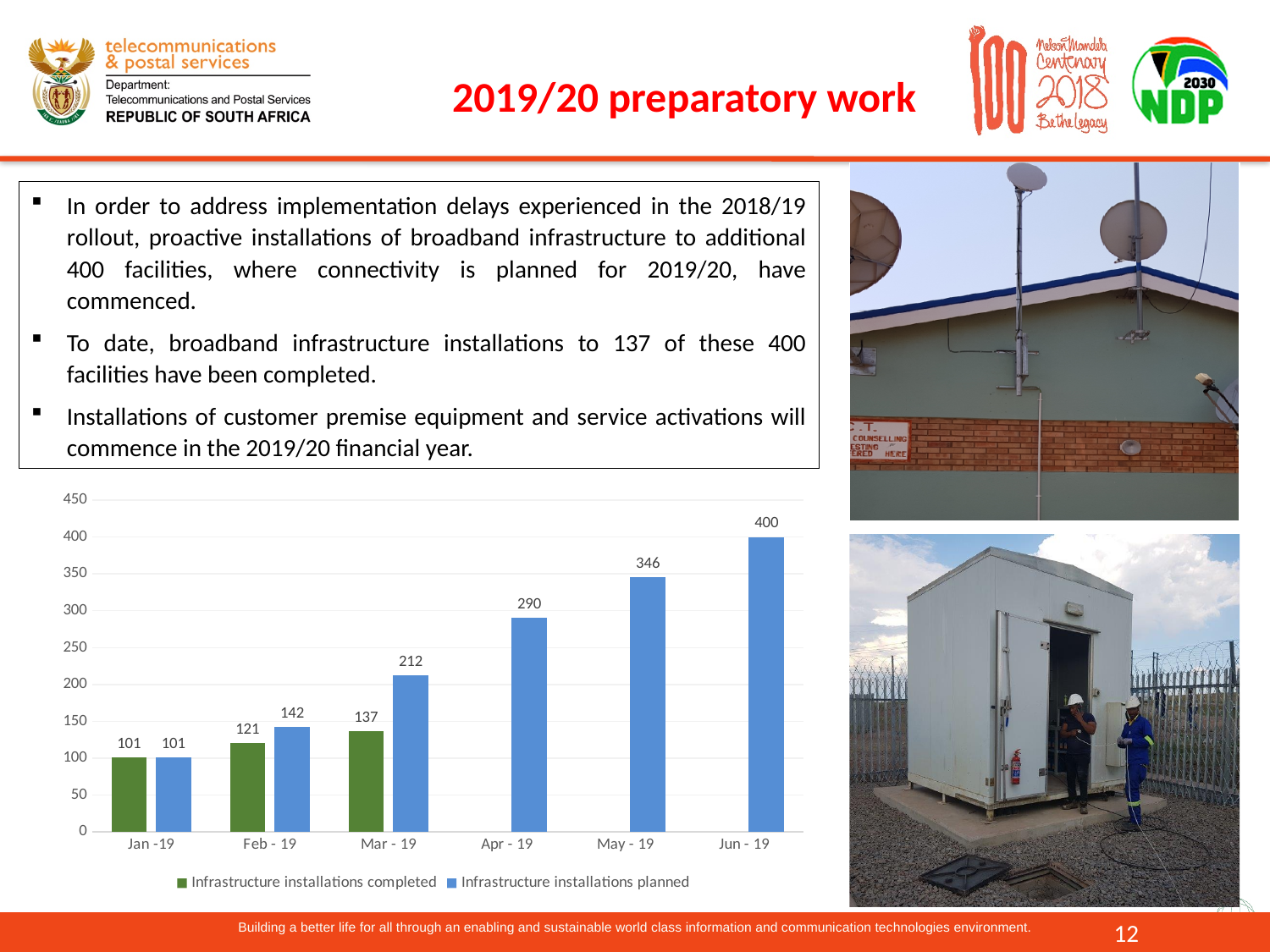
What kind of chart is shown on the slide? Bar chart What is the value for Infrastructure installations planned in Jun - 19? 400 Which month has the highest value for Infrastructure installations planned? Jun - 19 What is the value for Infrastructure installations completed in Mar - 19? 137 Do the values for Infrastructure installations planned rise or fall from Jan -19 to Jun - 19? Rise Which is larger in Feb - 19: Infrastructure installations planned or Infrastructure installations completed? Infrastructure installations planned What colour are the bars for Infrastructure installations completed? Green What is the difference between Infrastructure installations planned and Infrastructure installations completed in Mar - 19? 75 How many months are shown on the x axis of the chart? 6 How many series does the chart legend list? 2 What is the value for Infrastructure installations planned in Apr - 19? 290 Which month has the lowest value for Infrastructure installations completed? Jan -19